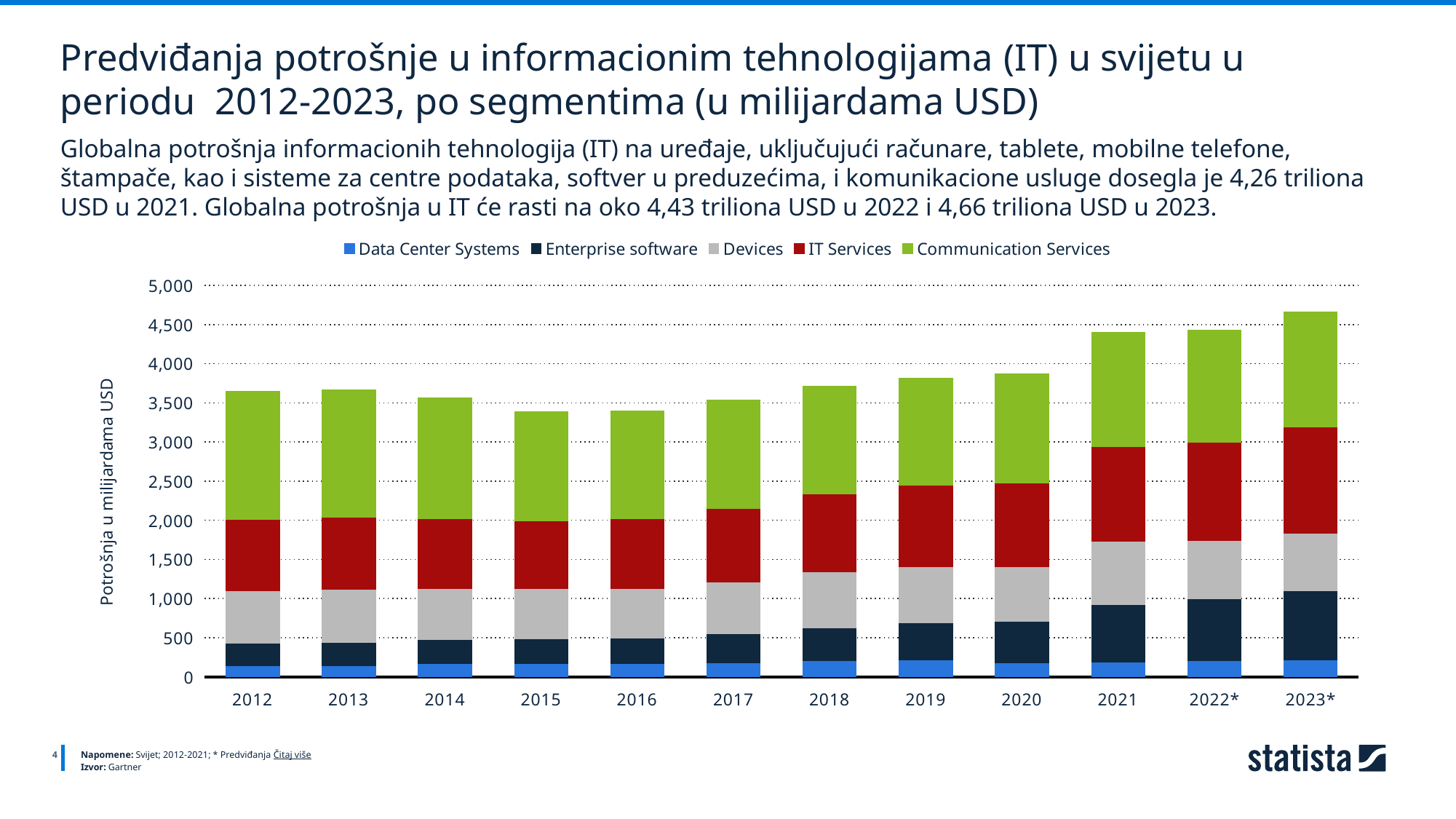
Do the total bars rise or fall from 2020 to 2023*? rise What is the label of the y axis of the chart? Potrošnja u milijardama USD Is the total bar for 2023* greater or less than 4,500? greater Is the total bar for 2021 greater or less than 4,000? greater Is the total bar for 2018 greater or less than 3,500? greater Which series is shown in green in the chart? Communication Services Which year has the highest total IT spending bar in the chart? 2023* What kind of chart is shown on the slide? Stacked bar chart Which year has the larger total bar, 2020 or 2021? 2021 How many years (bars) are shown on the x axis of the chart? 12 How many series does the chart's legend list? 5